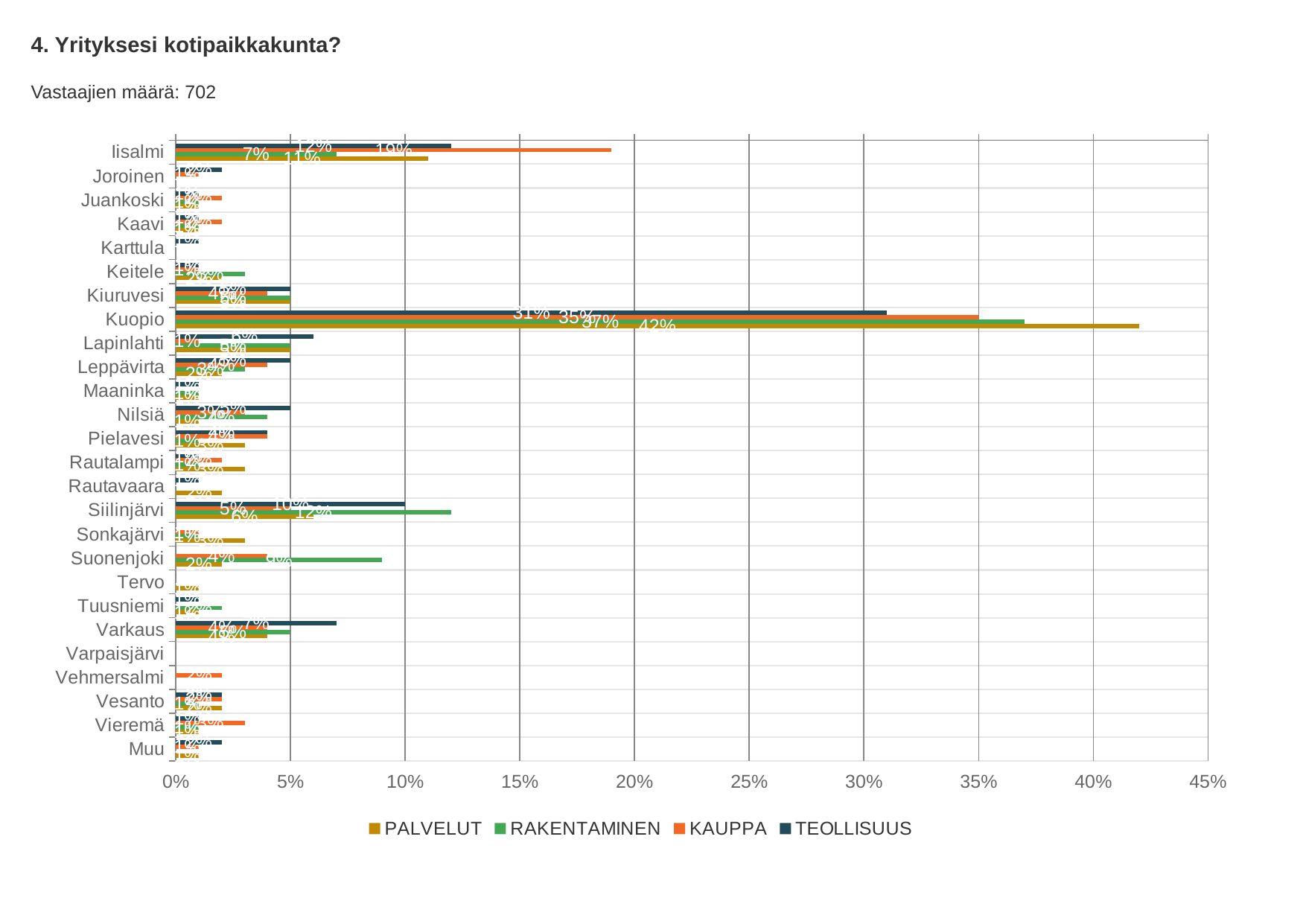
What is the RAKENTAMINEN value for Kuopio? 37% What kind of chart is shown on the slide? bar chart What is the title of the chart? 4. Yrityksesi kotipaikkakunta? How many municipality categories are shown on the y axis? 26 Is the TEOLLISUUS value for Varkaus greater or less than 5%? greater How many series does the legend list? 4 For Iisalmi, which is larger: the KAUPPA value or the TEOLLISUUS value? KAUPPA What is the KAUPPA value for Iisalmi? 19% Which municipality has the highest PALVELUT value? Kuopio What is the difference between the PALVELUT and TEOLLISUUS values for Kuopio? 11 percentage points What is the TEOLLISUUS value for Kuopio? 31% What is the PALVELUT value for Kuopio? 42%